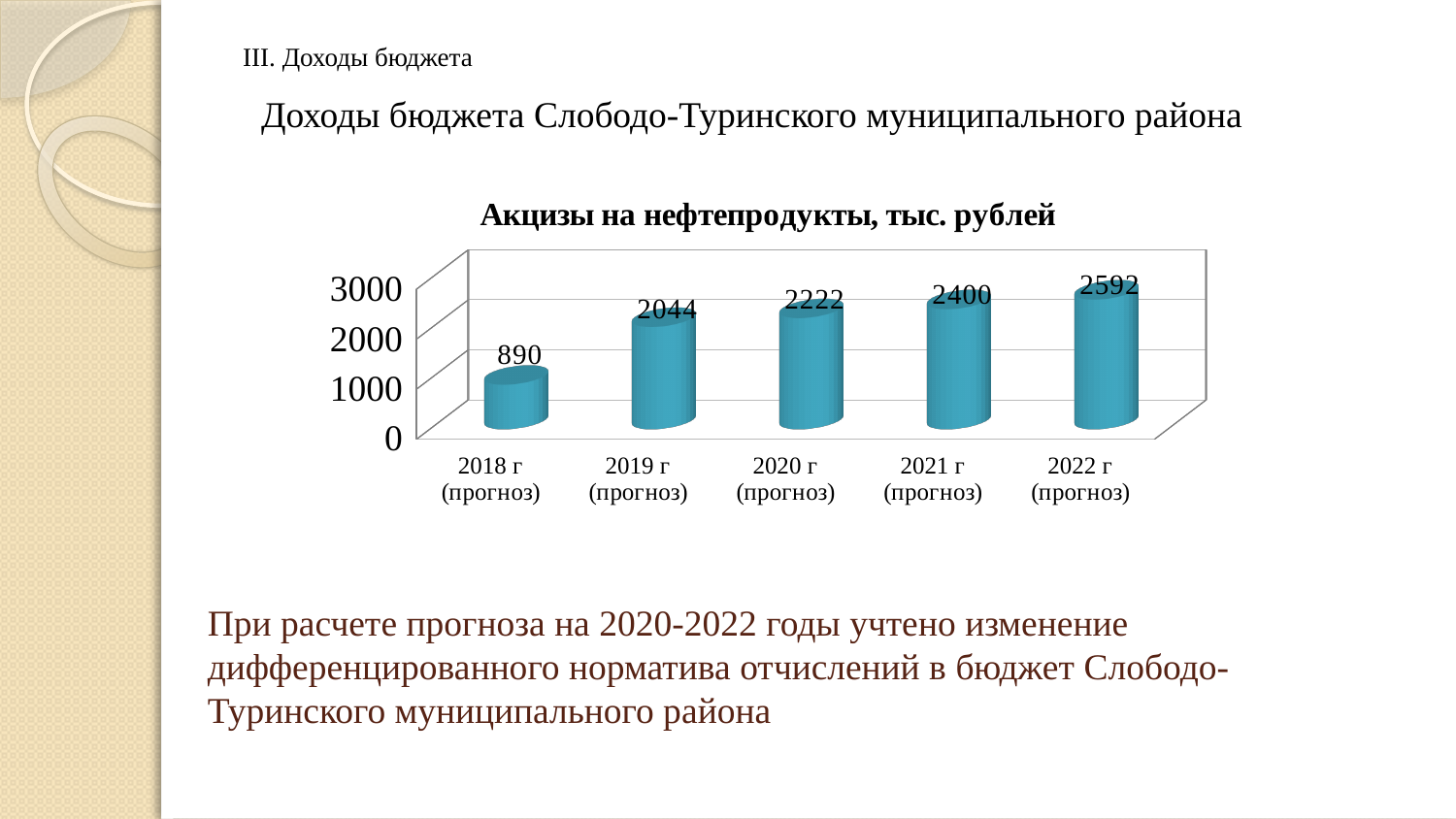
What is the value for 2020 г (прогноз)? 2222 Which year has the highest value? 2022 г (прогноз) What is the difference between the values for 2022 г (прогноз) and 2021 г (прогноз)? 192 What is the value for 2018 г (прогноз)? 890 What is the value for 2022 г (прогноз)? 2592 What kind of chart is this? bar chart Which is larger, the value for 2021 г (прогноз) or 2019 г (прогноз)? 2021 г (прогноз) Is the value for 2018 г (прогноз) greater or less than 1000? less Which year has the lowest value? 2018 г (прогноз) How many years are shown on the chart? 5 Do the values rise or fall from 2018 to 2022? rise What is the difference between the values for 2019 г (прогноз) and 2018 г (прогноз)? 1154